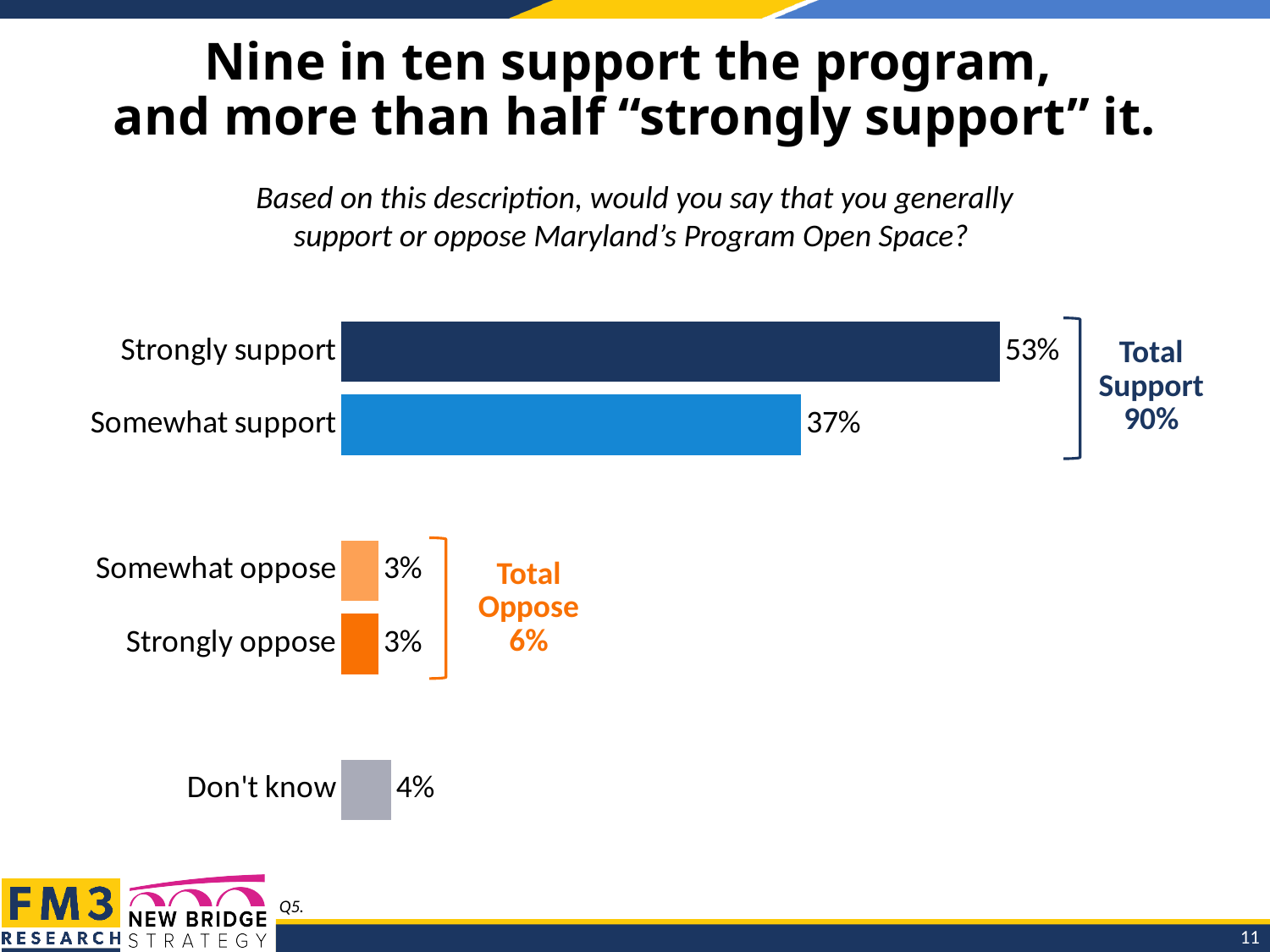
What is the Total Oppose percentage shown on the slide? 6% What percentage of respondents said they "Somewhat support" the program? 37% What percentage of respondents said they "Strongly oppose" the program? 3% What is the difference in percentage points between "Strongly support" and "Somewhat support"? 16 Which is larger, the percentage for "Don't know" or the percentage for "Somewhat oppose"? Don't know What colour is the "Don't know" bar? Gray How many response categories are shown in the chart? 5 What is the Total Support percentage shown on the slide? 90% What type of chart is shown on the slide? Bar chart Which response category has the highest percentage? Strongly support What percentage of respondents answered "Don't know"? 4% What percentage of respondents said they "Strongly support" the program? 53%